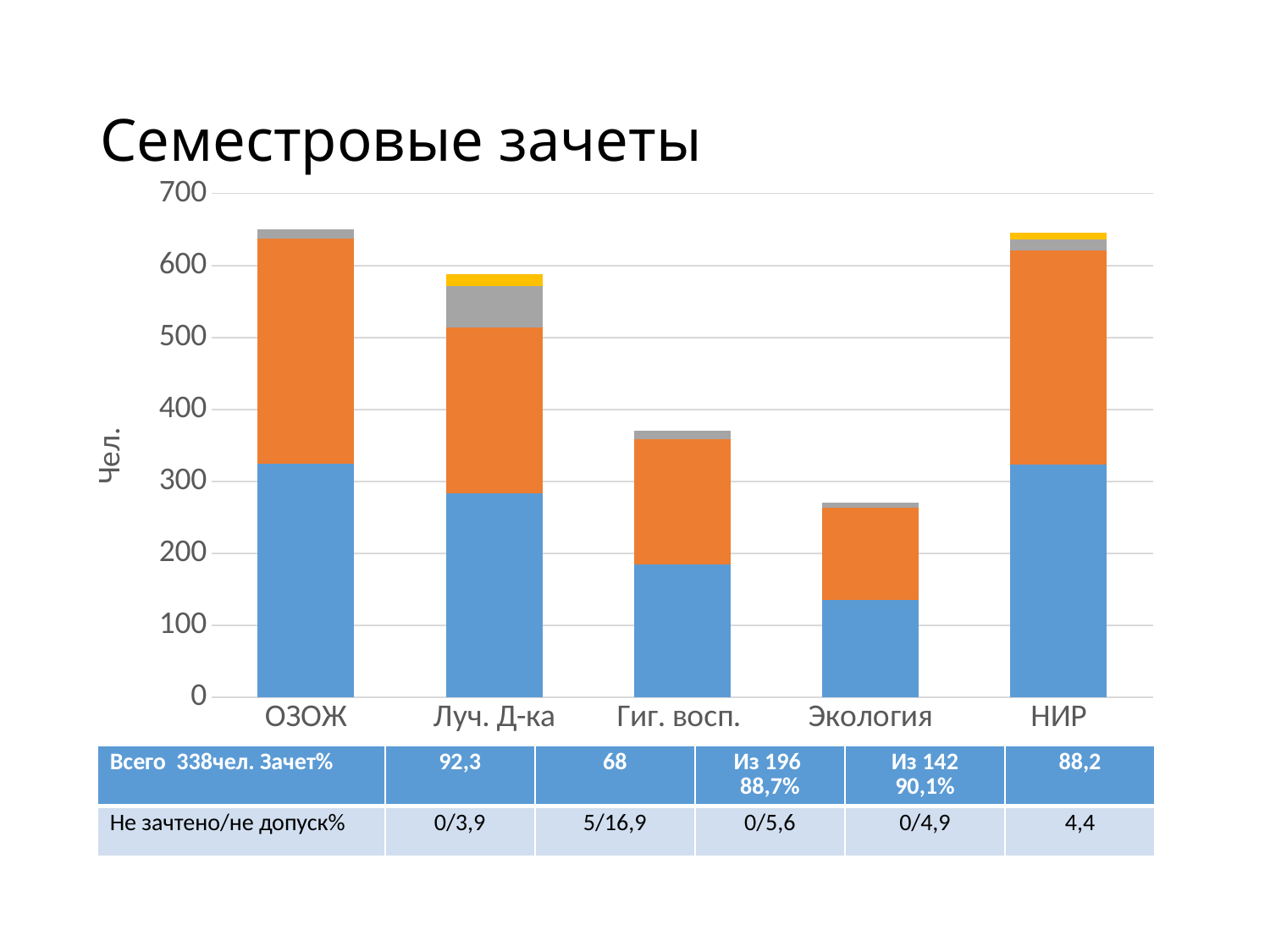
What kind of chart is shown on the slide? stacked bar chart Is the total bar height for ОЗОЖ greater or less than 600? greater Which category has the lowest total bar height? Экология Is the blue segment for Экология greater or less than 200? less Is the total bar height for Луч. Д-ка greater or less than 500? greater Do the total bar heights rise or fall from Луч. Д-ка to Экология? fall Which bar is taller in total, Луч. Д-ка or Гиг. восп.? Луч. Д-ка Which bar is taller in total, Экология or Гиг. восп.? Гиг. восп. How many categories are shown on the x axis of the chart? 5 What is the label on the y axis of the chart? Чел.